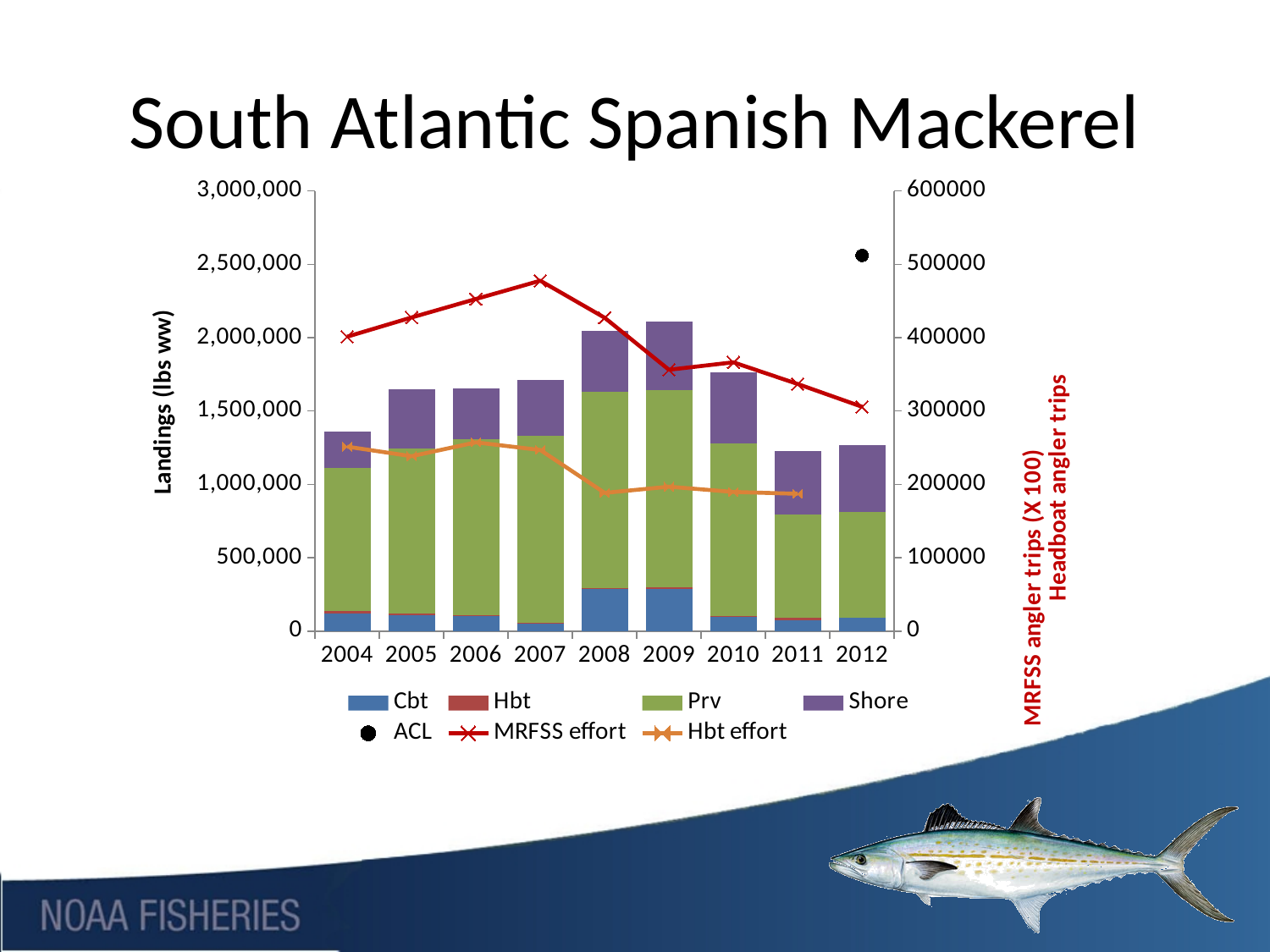
How many series does the chart's legend list? 7 Is the total landings bar for 2011 greater or less than 1,500,000? less What is the title of the chart on the slide? South Atlantic Spanish Mackerel In which year is the MRFSS effort line at its lowest value? 2012 In which year does the MRFSS effort line reach its highest value? 2007 Is the MRFSS effort value for 2007 greater or less than 400000? greater How many years are shown along the x axis of the chart? 9 Does the MRFSS effort line rise or fall from 2007 to 2012? fall Which year has the larger total landings bar, 2004 or 2009? 2009 What is the label of the left vertical axis? Landings (lbs ww) What kind of chart is shown on the slide? Stacked bar chart with line series Is the total landings bar for 2009 greater or less than 2,000,000? greater